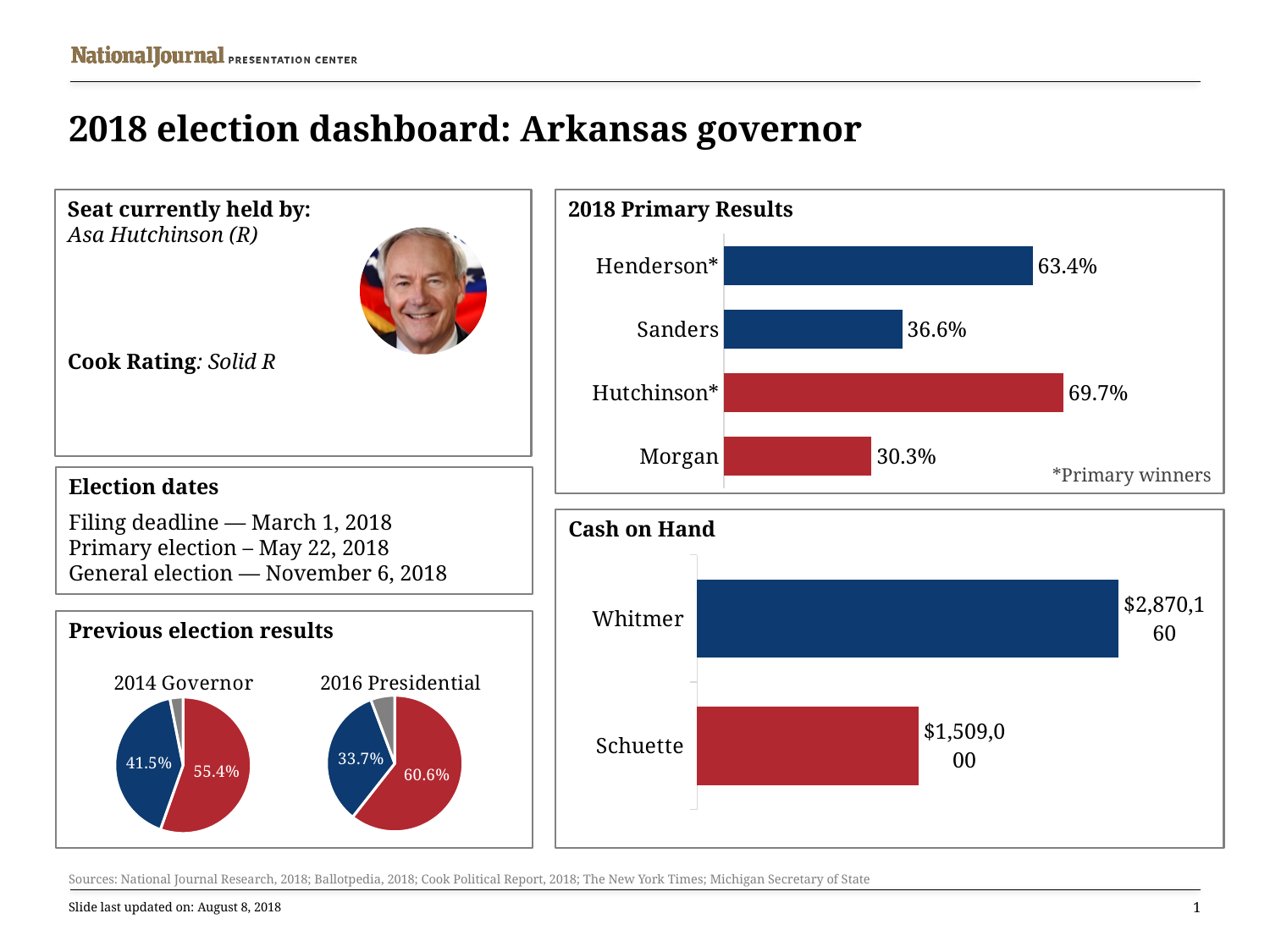
In the 2018 Primary Results chart, which candidate has the highest value? Hutchinson* In the 2018 Primary Results chart, what is the difference between Hutchinson* and Morgan? 39.4% In the 2016 Presidential pie chart, what share does the blue slice represent? 33.7% In the Cash on Hand chart, what is the value for Schuette? $1,509,000 In the 2018 Primary Results chart, how many candidates are shown? 4 In the 2014 Governor pie chart, what share does the red slice represent? 55.4% In the Cash on Hand chart, what is the value for Whitmer? $2,870,160 In the 2018 Primary Results chart, what is the value for Henderson*? 63.4% In the 2018 Primary Results chart, which candidate has the lowest value? Morgan In the Cash on Hand chart, which candidate has more cash on hand, Whitmer or Schuette? Whitmer What kind of chart is the 2018 Primary Results chart? Bar chart In the 2018 Primary Results chart, what is the value for Morgan? 30.3%